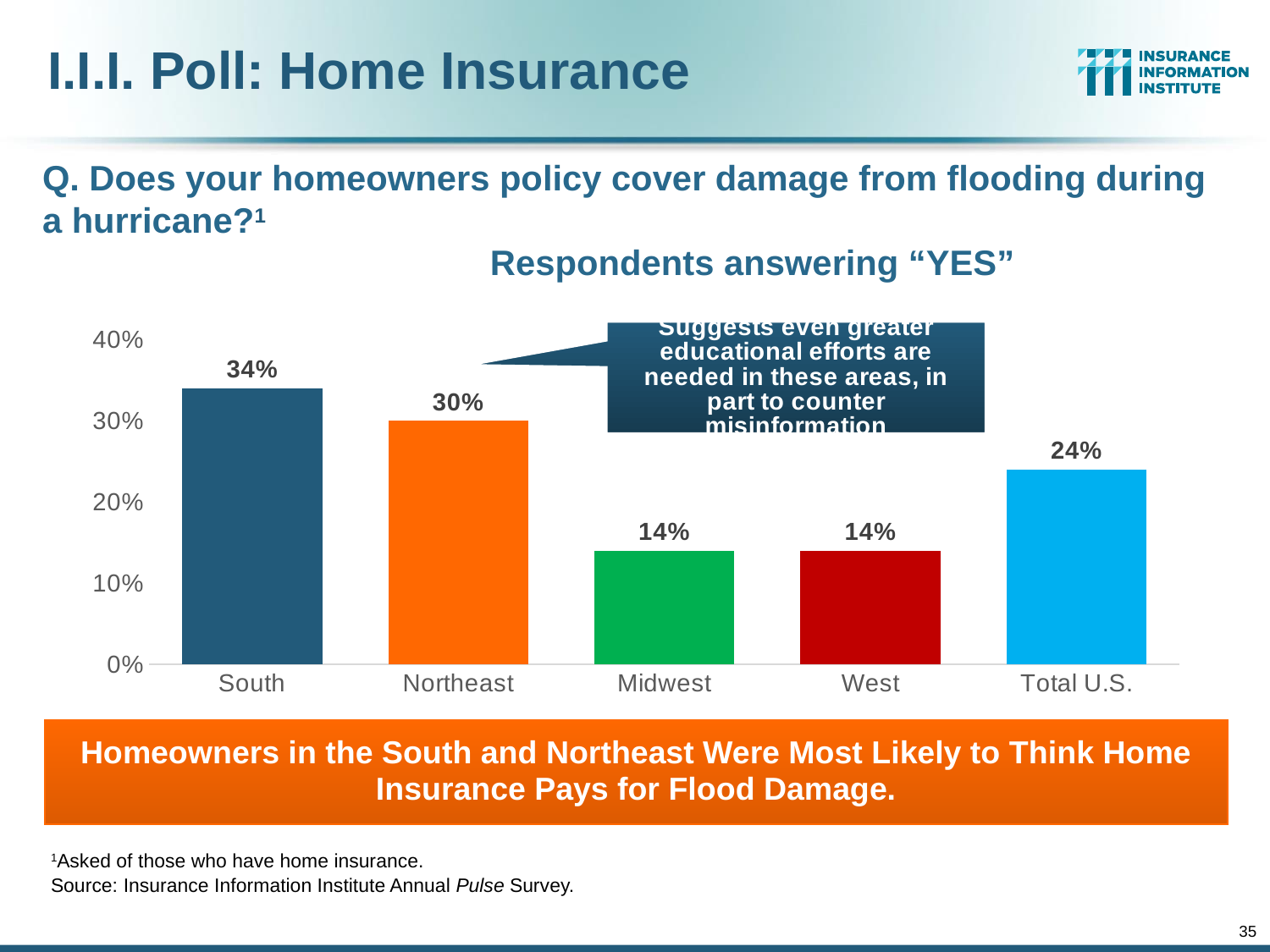
Which is larger, the value for the South or the value for Total U.S.? South What is the chart's title? Respondents answering "YES" What is the value shown for Total U.S.? 24% What is the difference between the Northeast and Total U.S. values? 6% How many categories are shown on the x axis? 5 Is the value for the West greater or less than 20%? less What percentage of respondents in the South answered "YES"? 34% What kind of chart is shown on the slide? bar chart What is the difference between the South and Northeast values? 4% What is the value shown for the Midwest? 14% Which region has the highest share of respondents answering "YES"? South What is the value shown for the Northeast? 30%